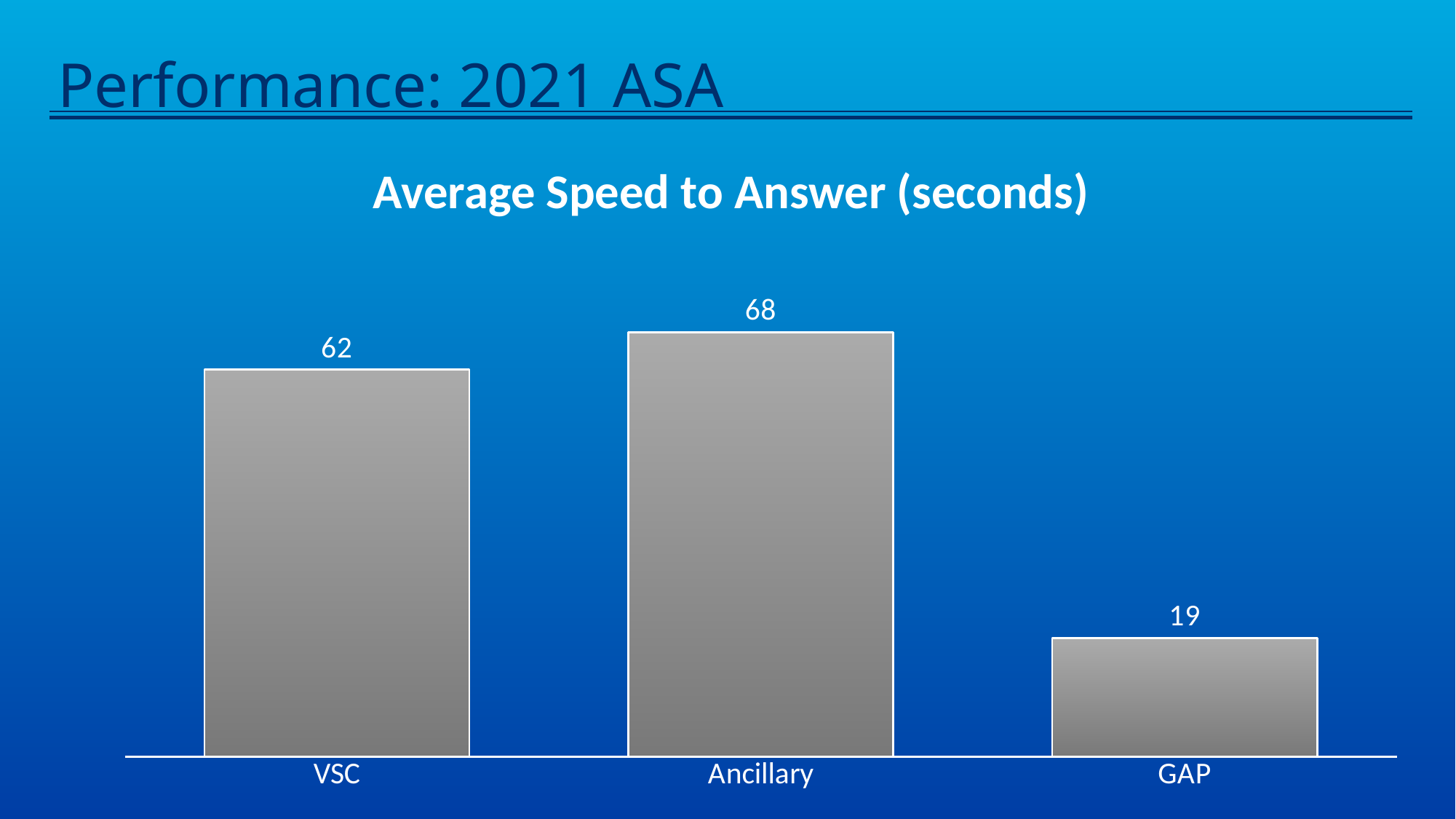
What is the average speed to answer for Ancillary? 68 What is the difference between the VSC and GAP values? 43 What unit is the average speed to answer measured in, according to the chart title? seconds What kind of chart is shown on the slide? Bar chart What is the difference between the Ancillary and VSC values? 6 How many categories are shown in the chart? 3 Which category has the lowest average speed to answer? GAP Which category has the highest average speed to answer? Ancillary What is the title of the chart? Average Speed to Answer (seconds) Which is larger, the value for VSC or the value for GAP? VSC What is the average speed to answer for VSC? 62 What is the average speed to answer for GAP? 19